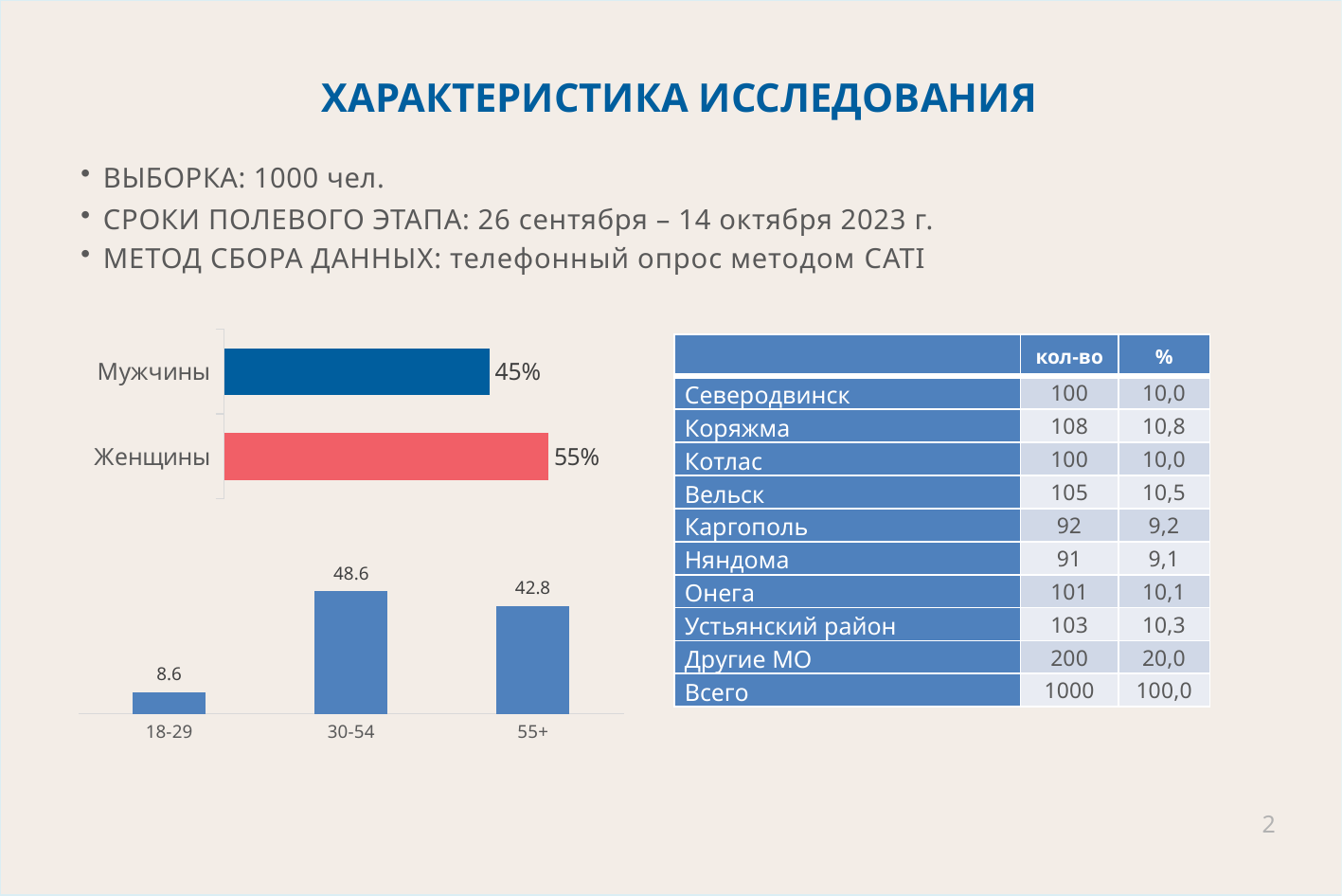
In the gender bar chart at the top left of the slide, what is the difference between the values for Женщины and Мужчины? 10% In the age bar chart at the bottom left of the slide, what is the value for the 30-54 group? 48.6 How many age groups are shown in the age bar chart at the bottom left of the slide? 3 In the gender bar chart at the top left of the slide, which category has the higher value? Женщины In the age bar chart at the bottom left of the slide, which age group has the highest value? 30-54 In the age bar chart at the bottom left of the slide, what is the value for the 18-29 group? 8.6 In the age bar chart at the bottom left of the slide, what is the difference between the values for 30-54 and 55+? 5.8 In the gender bar chart at the top left of the slide, what is the value for Мужчины? 45% In the age bar chart at the bottom left of the slide, what is the value for the 55+ group? 42.8 What kind of chart is the gender chart at the top left of the slide? bar chart In the gender bar chart at the top left of the slide, what is the value for Женщины? 55% In the age bar chart at the bottom left of the slide, which age group has the lowest value? 18-29